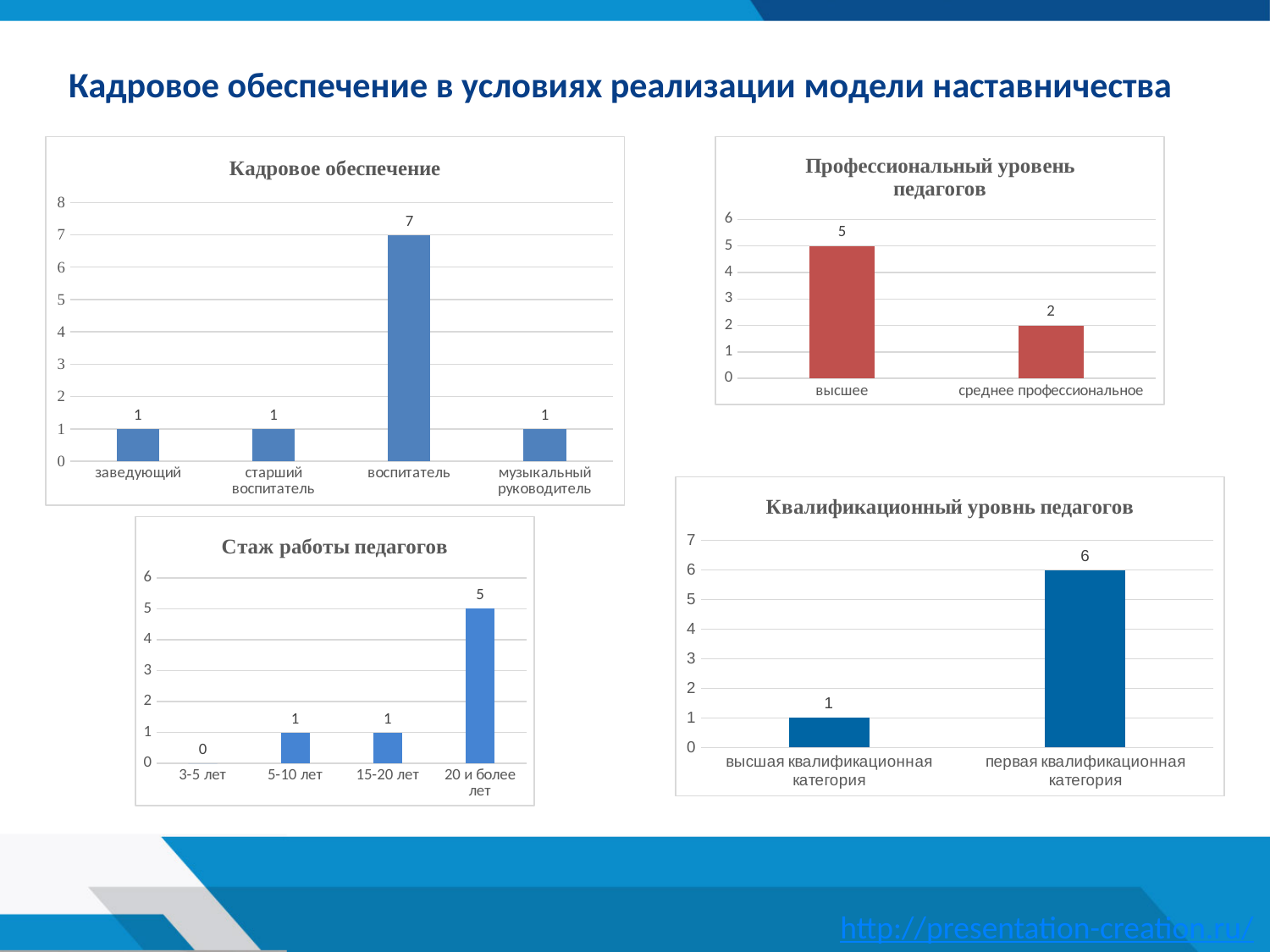
What kind of chart is the chart titled "Квалификационный уровнь педагогов"? bar chart In the chart titled "Профессиональный уровень педагогов", what is the value for высшее? 5 In the chart titled "Кадровое обеспечение", how many categories are shown on the x axis? 4 In the chart titled "Стаж работы педагогов", which category has the lowest value? 3-5 лет In the chart titled "Профессиональный уровень педагогов", which is larger: высшее or среднее профессиональное? высшее In the chart titled "Кадровое обеспечение", which category has the highest value? воспитатель In the chart titled "Кадровое обеспечение", what is the difference between the values for воспитатель and заведующий? 6 In the chart titled "Квалификационный уровнь педагогов", what is the value for первая квалификационная категория? 6 In the chart titled "Профессиональный уровень педагогов", what is the difference between высшее and среднее профессиональное? 3 In the chart titled "Стаж работы педагогов", what is the value for 20 и более лет? 5 In the chart titled "Стаж работы педагогов", how many categories are shown on the x axis? 4 In the chart titled "Кадровое обеспечение", what is the value for воспитатель? 7